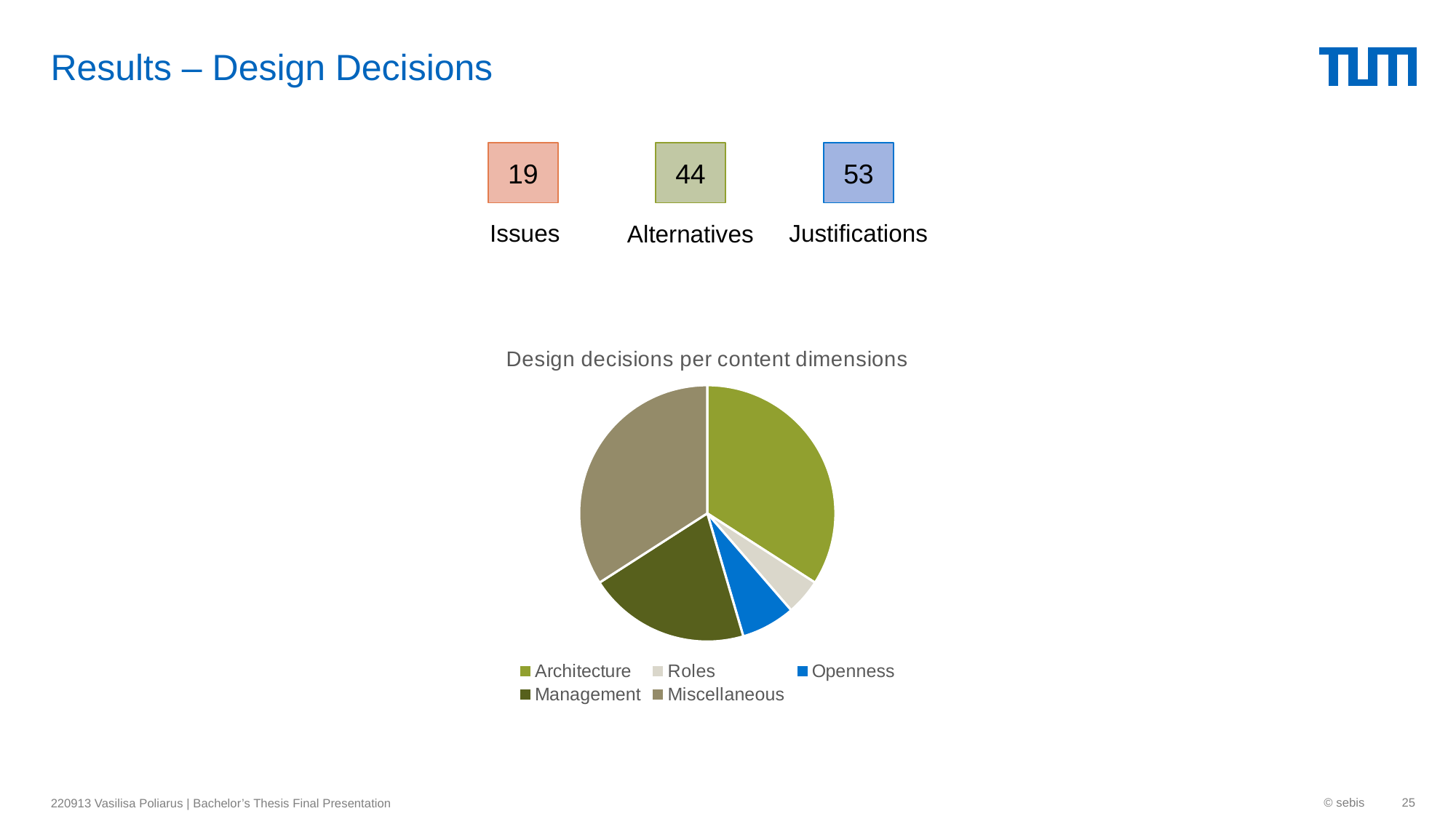
Which slice is larger in the pie chart, Management or Openness? Management Which category in the pie chart is shown in blue? Openness Which slice is larger in the pie chart, Miscellaneous or Roles? Miscellaneous How many slices does the pie chart have? 5 Which category has the smallest slice in the pie chart? Roles Which slice is larger in the pie chart, Architecture or Management? Architecture How many categories does the legend of the pie chart list? 5 What is the title of the pie chart? Design decisions per content dimensions What kind of chart is shown on the slide? pie chart